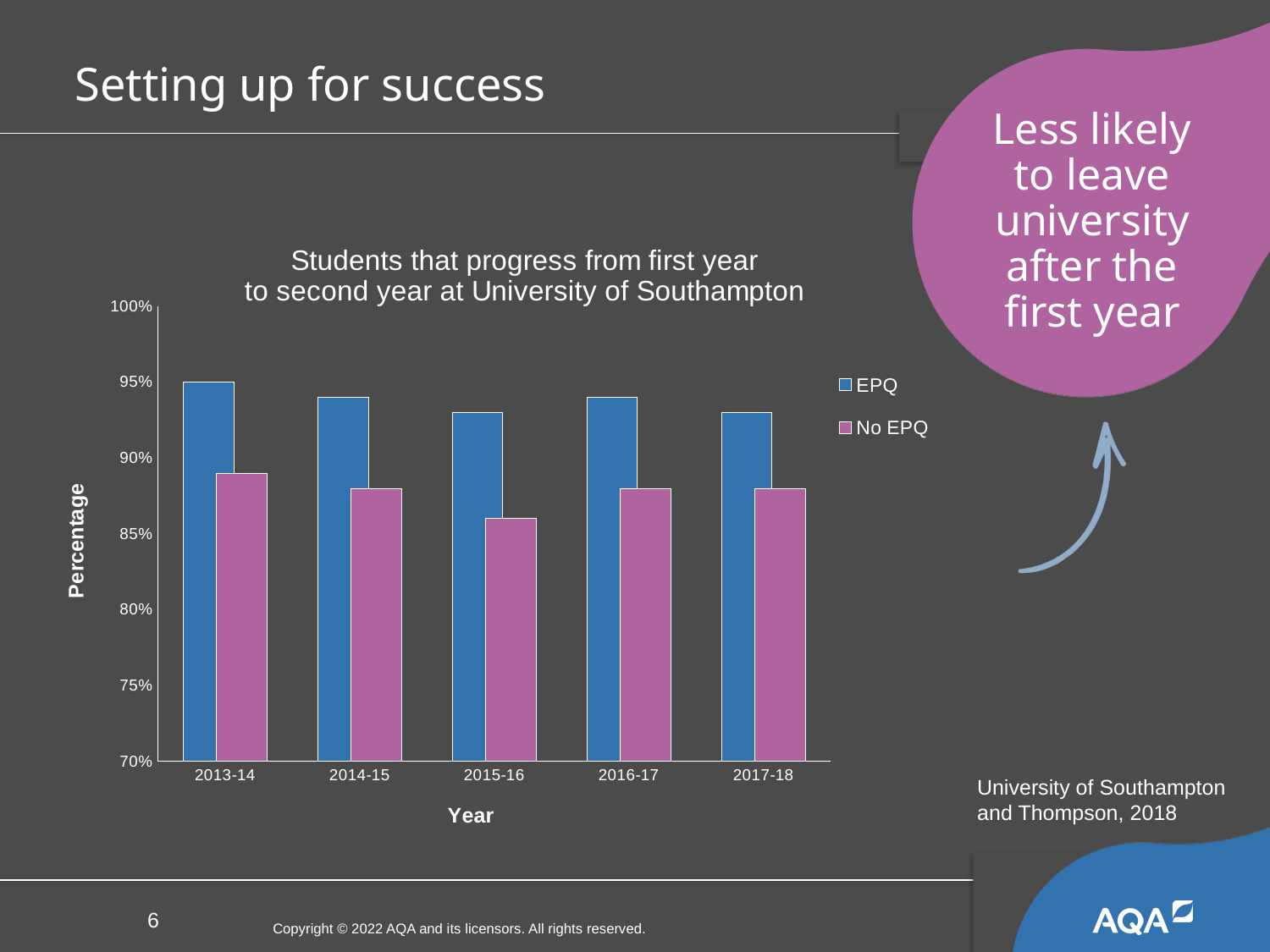
In which year is the No EPQ value lowest? 2015-16 How many series does the chart legend list? 2 In 2015-16, which is larger: the EPQ value or the No EPQ value? EPQ In 2016-17, which series has the higher value, EPQ or No EPQ? EPQ What kind of chart is shown on the slide? bar chart Is the No EPQ value for 2013-14 greater or less than 85%? greater Is the No EPQ value for 2015-16 greater or less than 90%? less Is the EPQ value for 2017-18 greater or less than 90%? greater What is the title of the chart? Students that progress from first year to second year at University of Southampton How many years are shown on the x axis of the chart? 5 What are the two series named in the chart legend? EPQ and No EPQ